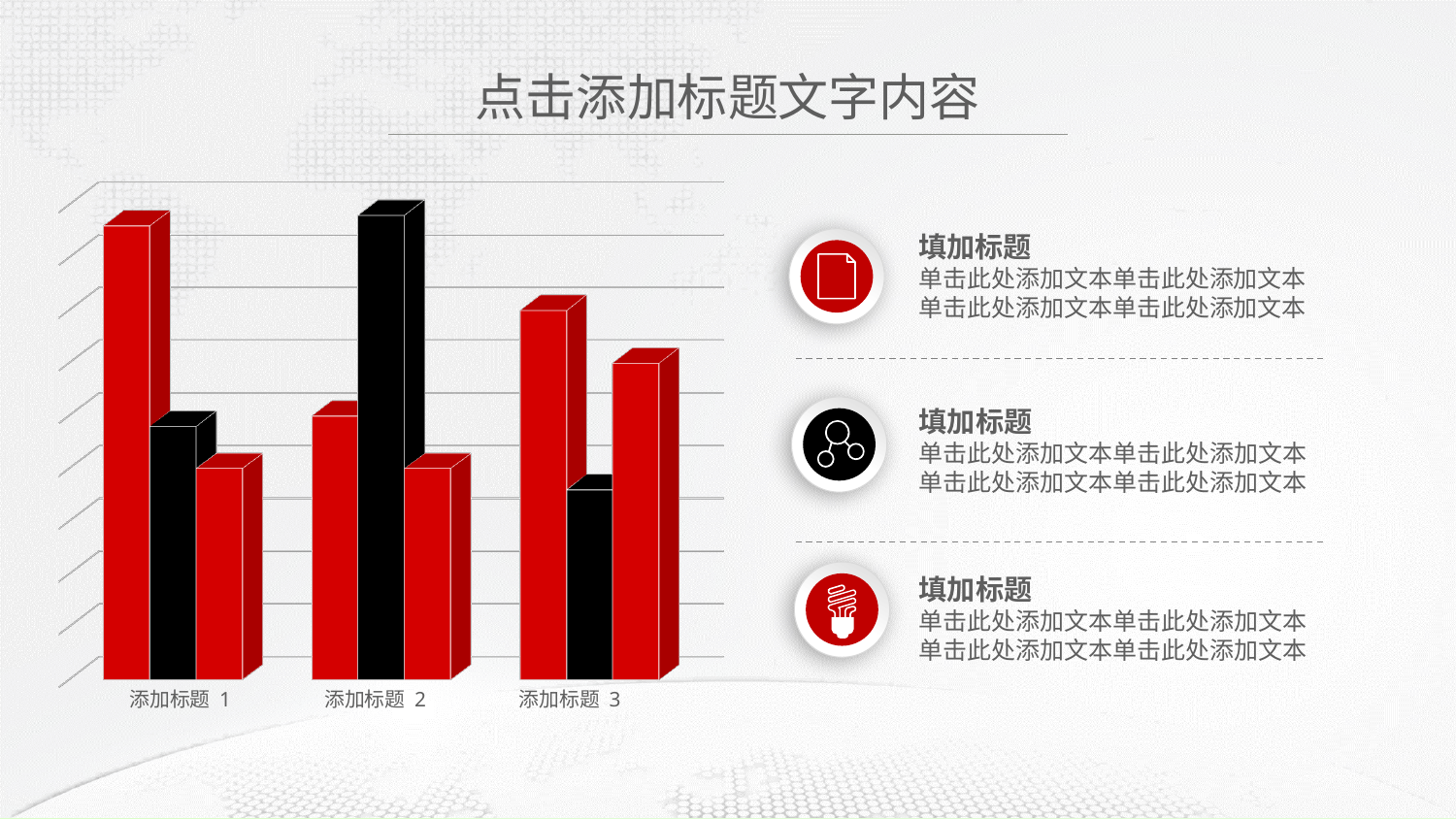
How many bars are plotted for each category in the bar chart? 3 In the category 添加标题 2, which bar is the tallest? the black bar How many categories are shown along the x axis of the bar chart? 3 In the category 添加标题 2, is the black bar taller or shorter than the leftmost red bar? taller In the category 添加标题 1, which bar is the tallest? the leftmost red bar What two colours are used for the bars in the chart? red and black In the category 添加标题 3, which bar is the shortest? the black bar Does the bar chart display a legend? No In the category 添加标题 1, is the black bar taller or shorter than the leftmost red bar? shorter In the category 添加标题 3, is the black bar taller or shorter than the rightmost red bar? shorter How many bars are plotted in total in the bar chart? 9 What kind of chart is shown on the left of the slide? bar chart